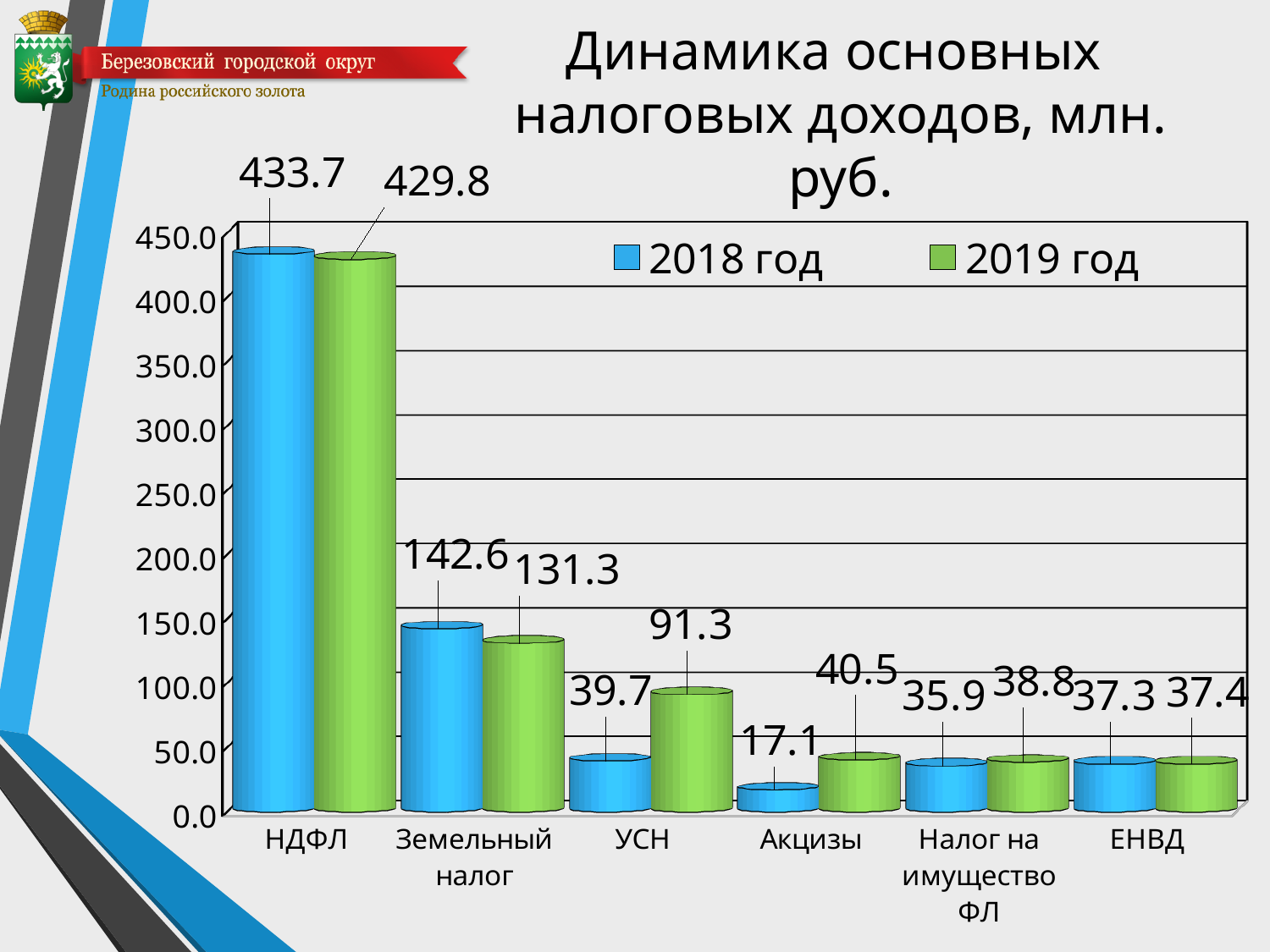
Which category has the lowest value in the 2018 год series? Акцизы What is the value for Акцизы in the 2018 год series? 17.1 What is the difference between the 2018 год and 2019 год values for Земельный налог? 11.3 What is the difference between the 2019 год and 2018 год values for УСН? 51.6 What is the value for УСН in the 2019 год series? 91.3 How many categories are shown on the x axis? 6 For Акцизы, which series has the larger value, 2018 год or 2019 год? 2019 год What is the value for НДФЛ in the 2018 год series? 433.7 What is the value for Налог на имущество ФЛ in the 2019 год series? 38.8 Which category has the highest value in the 2019 год series? НДФЛ How many series does the legend list? 2 What kind of chart is shown on the slide? Bar chart